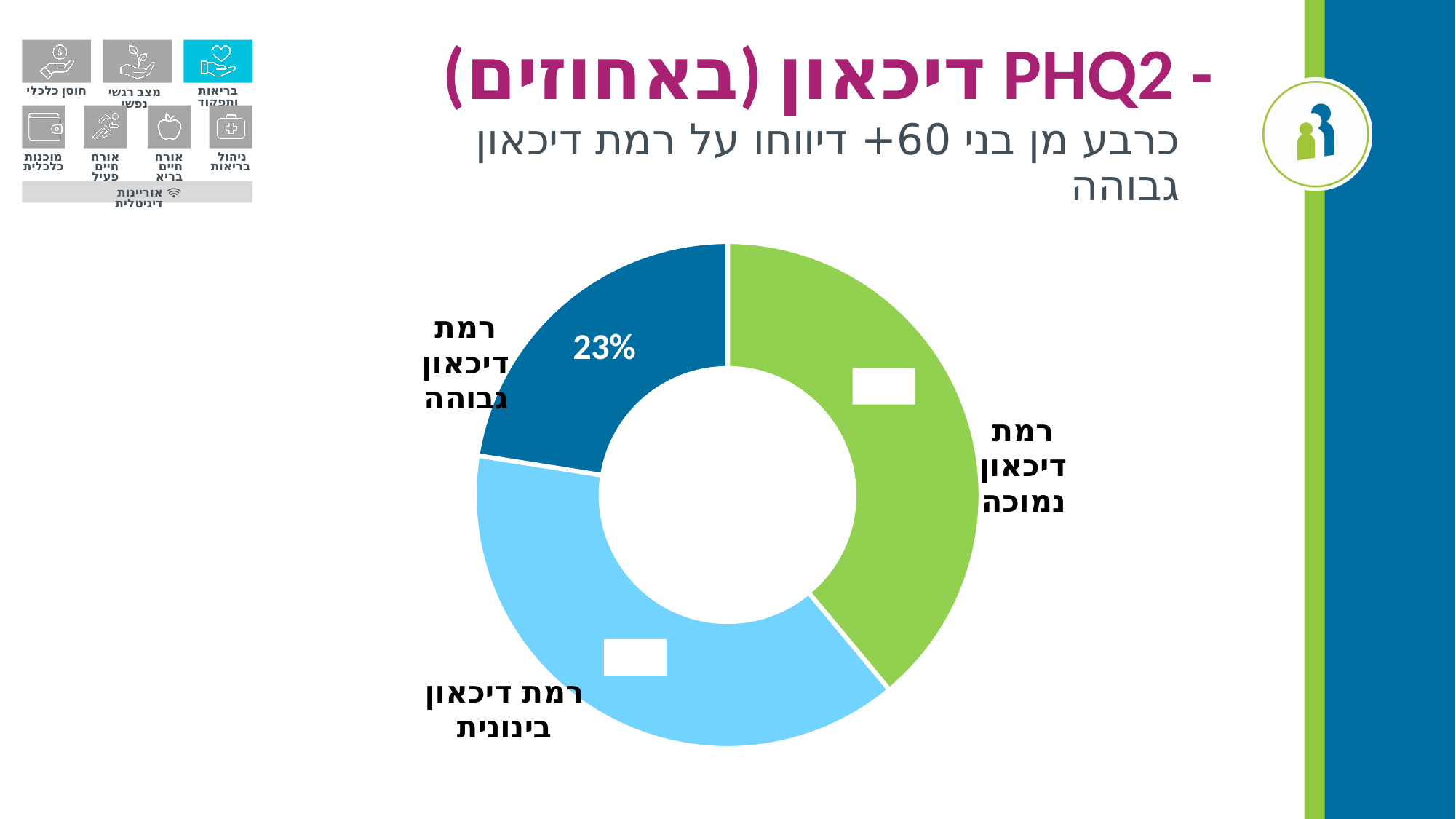
Which category has the smallest slice in the donut chart? רמת דיכאון גבוהה How many categories (slices) does the chart show? 3 What is the title of the chart slide? PHQ2 - דיכאון (באחוזים) What colour is the רמת דיכאון גבוהה slice? Dark blue Which slice is larger: רמת דיכאון גבוהה or רמת דיכאון בינונית? רמת דיכאון בינונית What share of the pie does רמת דיכאון גבוהה represent? 23% What kind of chart is shown on the slide? Pie (donut) chart What percentage is shown for the רמת דיכאון גבוהה slice? 23% Which slice is larger: רמת דיכאון גבוהה or רמת דיכאון נמוכה? רמת דיכאון נמוכה